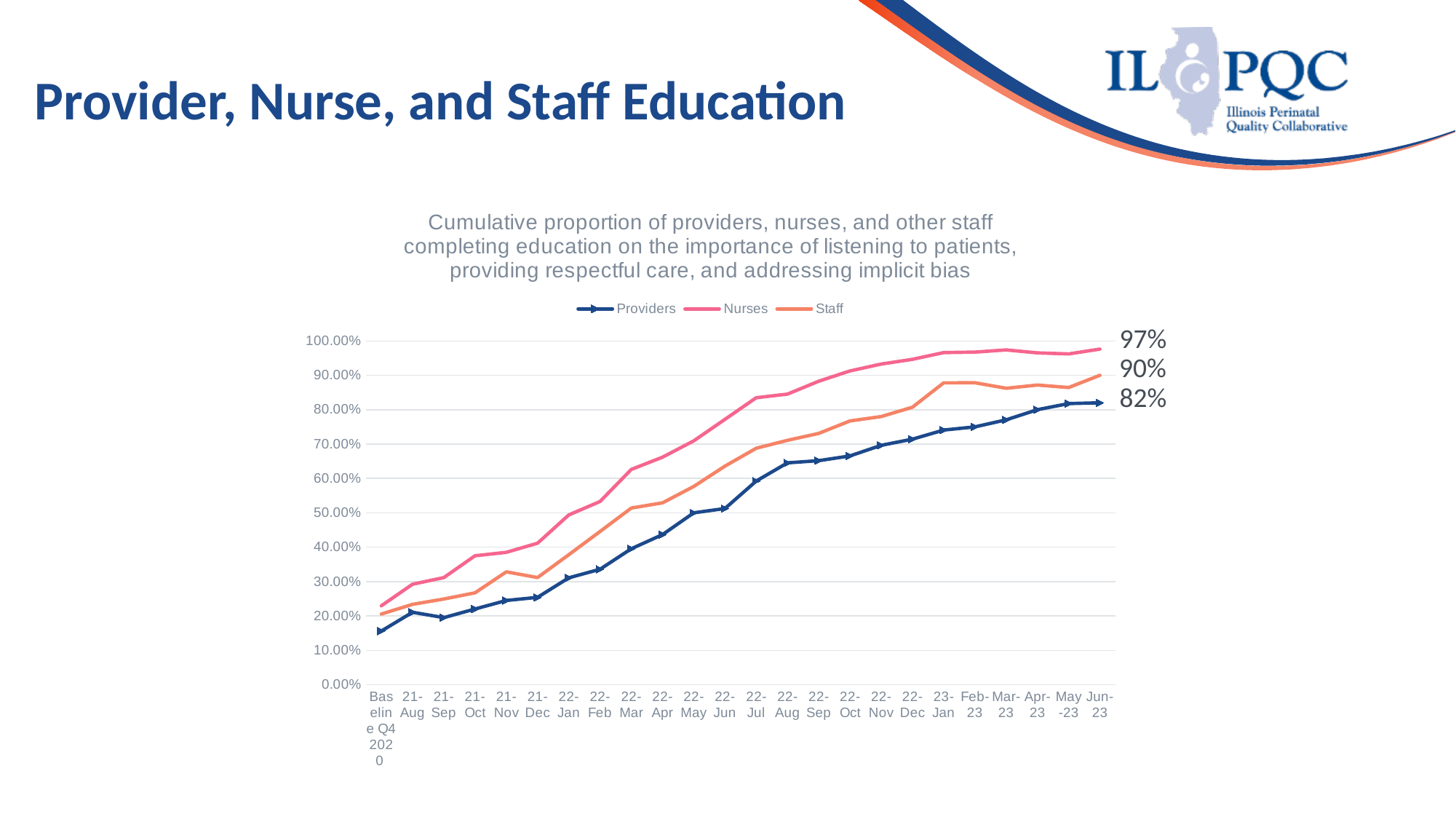
What kind of chart is shown on the slide? line chart Is the value for Nurses at 22-Jul greater or less than 80.00%? greater How many series does the legend list? 3 Which series has the highest value at Jun-23? Nurses Which series has the lowest value at Jun-23? Providers What is the difference between the Nurses and Providers values at Jun-23? 15% Is the value for Providers at Baseline Q4 2020 greater or less than 20.00%? less What is the value for Nurses at Jun-23? 97% Do the values for Providers rise or fall from Baseline Q4 2020 to Jun-23? rise How many time points are shown on the x axis? 24 What is the value for Staff at Jun-23? 90% What is the value for Providers at Jun-23? 82%